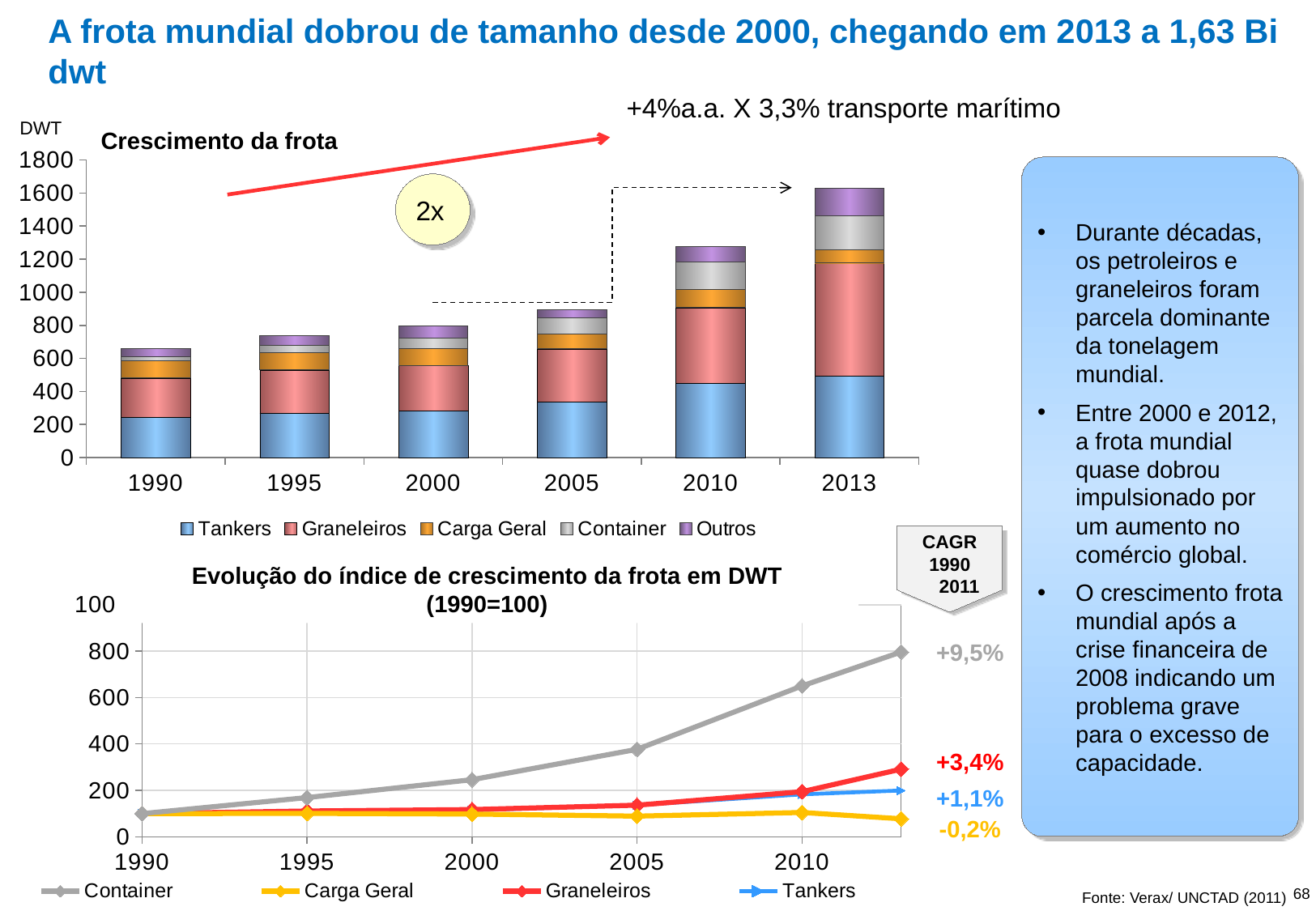
In the 'Evolução do índice de crescimento da frota em DWT' chart, which series is higher in 2013, Graneleiros or Tankers? Graneleiros In the 'Evolução do índice de crescimento da frota em DWT' chart, which series has the highest value in 2013? Container How many series does the legend of the 'Evolução do índice de crescimento da frota em DWT' chart list? 4 What kind of chart is the 'Crescimento da frota' chart? bar chart How many years are shown on the x axis of the 'Crescimento da frota' chart? 6 How many series does the legend of the 'Crescimento da frota' chart list? 5 In the 'Evolução do índice de crescimento da frota em DWT' chart, does the Container series rise or fall from 1990 to 2013? rise What kind of chart is the 'Evolução do índice de crescimento da frota em DWT' chart? line chart In the 'Crescimento da frota' chart, is the total for 2013 greater or less than 1400? greater In the 'Crescimento da frota' chart, which year has the tallest stacked bar? 2013 In the 'Evolução do índice de crescimento da frota em DWT' chart, what CAGR 1990-2011 is shown for Container? +9,5% In the 'Crescimento da frota' chart, is the total for 1990 greater or less than 800? less